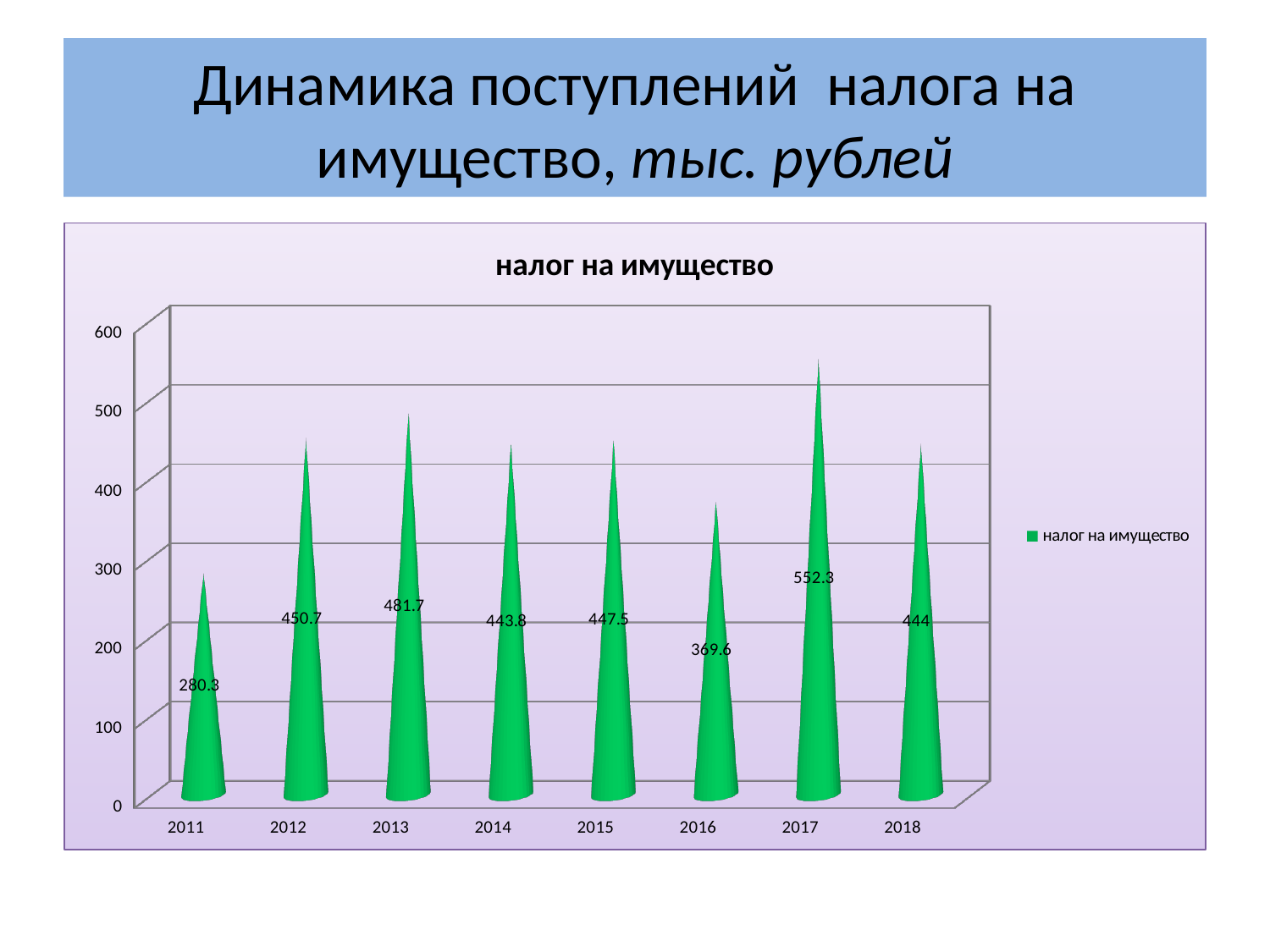
What is the value for 2016? 369.6 Which year has the lowest value? 2011 How many years are shown on the x axis? 8 Which is larger, the value for 2013 or the value for 2016? 2013 What is the value for 2011? 280.3 What is the difference between the values for 2013 and 2012? 31 What is the title of the chart? налог на имущество Which year has the highest value? 2017 What is the difference between the values for 2017 and 2011? 272 How many series does the legend list? 1 What is the value for 2018? 444 What is the value for 2017? 552.3